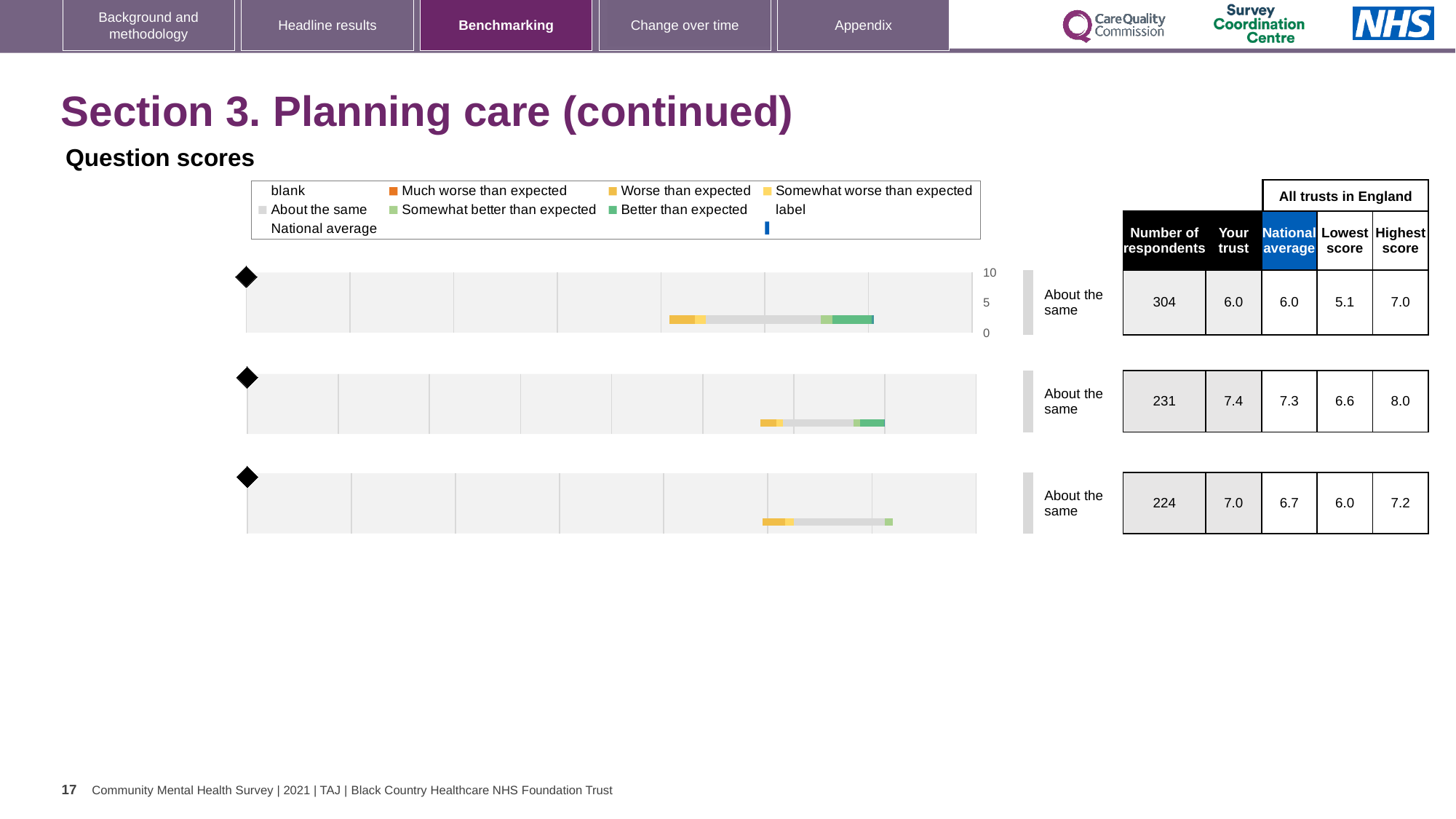
For the top chart, what is the 'Your trust' score shown in the table? 6.0 Which of the three charts has the lowest number of respondents: top, middle or bottom? bottom For the bottom chart, what is the national average shown in the table? 6.7 For the top chart, how many respondents are listed in the table? 304 For the middle chart, what is the 'Your trust' score shown in the table? 7.4 For the bottom chart, what is the difference between the highest score and the lowest score in the table? 1.2 What kind of chart is used for each question score on the slide? bar chart For the middle chart, what is the highest score among all trusts in England? 8.0 Is the 'Your trust' score for the middle chart larger than the 'Your trust' score for the bottom chart? Yes Which of the three charts has the highest 'Your trust' score in the table: top, middle or bottom? middle How many benchmarking charts are shown on the slide? 3 What is the maximum value shown on the axis of the top chart? 10